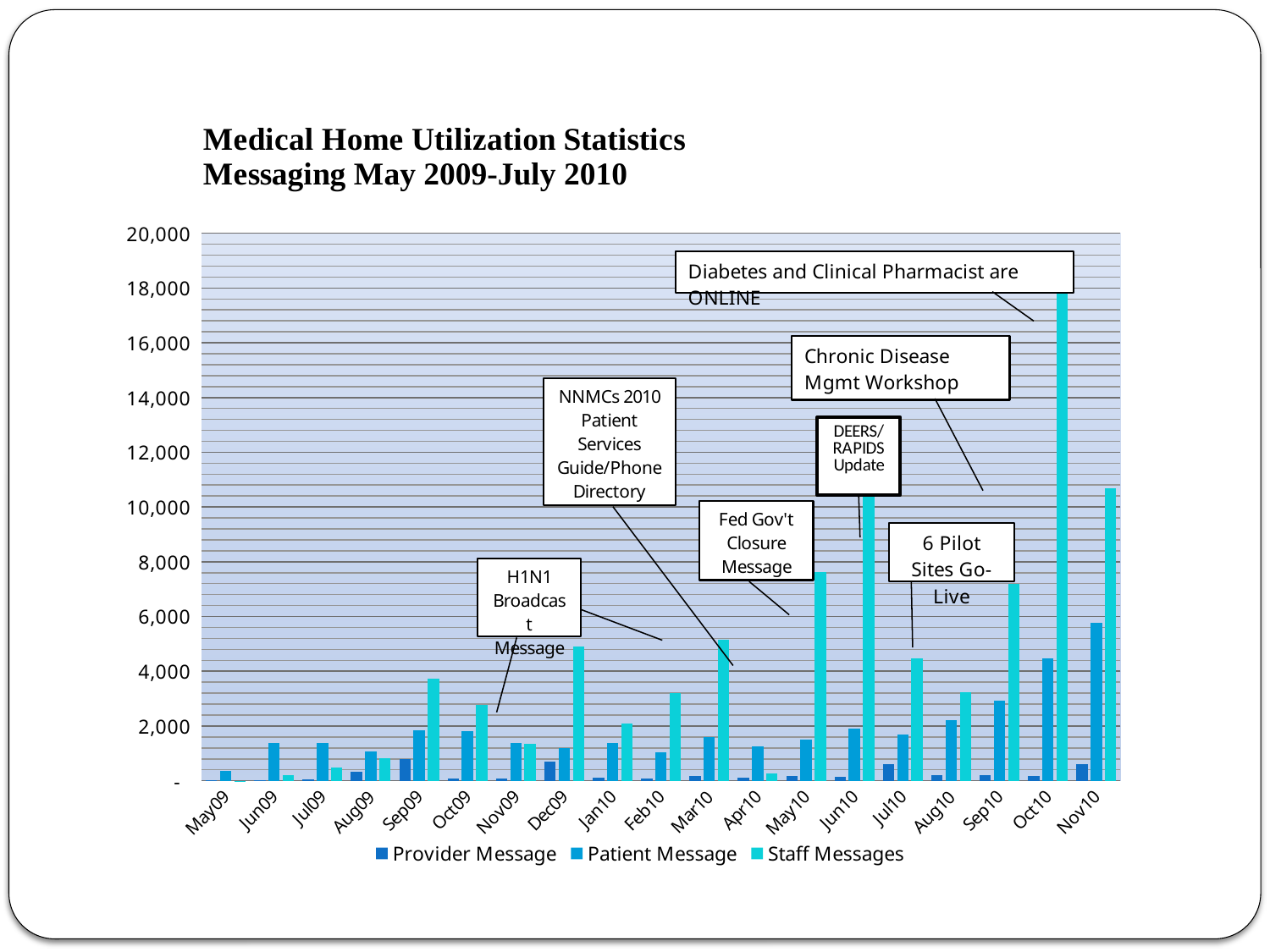
Which is larger, the Staff Messages value for Oct10 or for Nov10? Oct10 Is the Patient Message value for Nov10 greater or less than 4,000? greater What kind of chart is shown on the slide? bar chart Is the Staff Messages value for Sep09 greater or less than 2,000? greater Which month has the highest Staff Messages value? Oct10 Do the Patient Message values rise or fall from Jul10 to Nov10? rise What is the title of the chart? Medical Home Utilization Statistics Messaging May 2009-July 2010 How many series does the legend list? 3 Is the Staff Messages value for May10 greater or less than 6,000? greater Which is larger, the Patient Message value for Nov10 or for Oct10? Nov10 How many months are shown along the x axis? 19